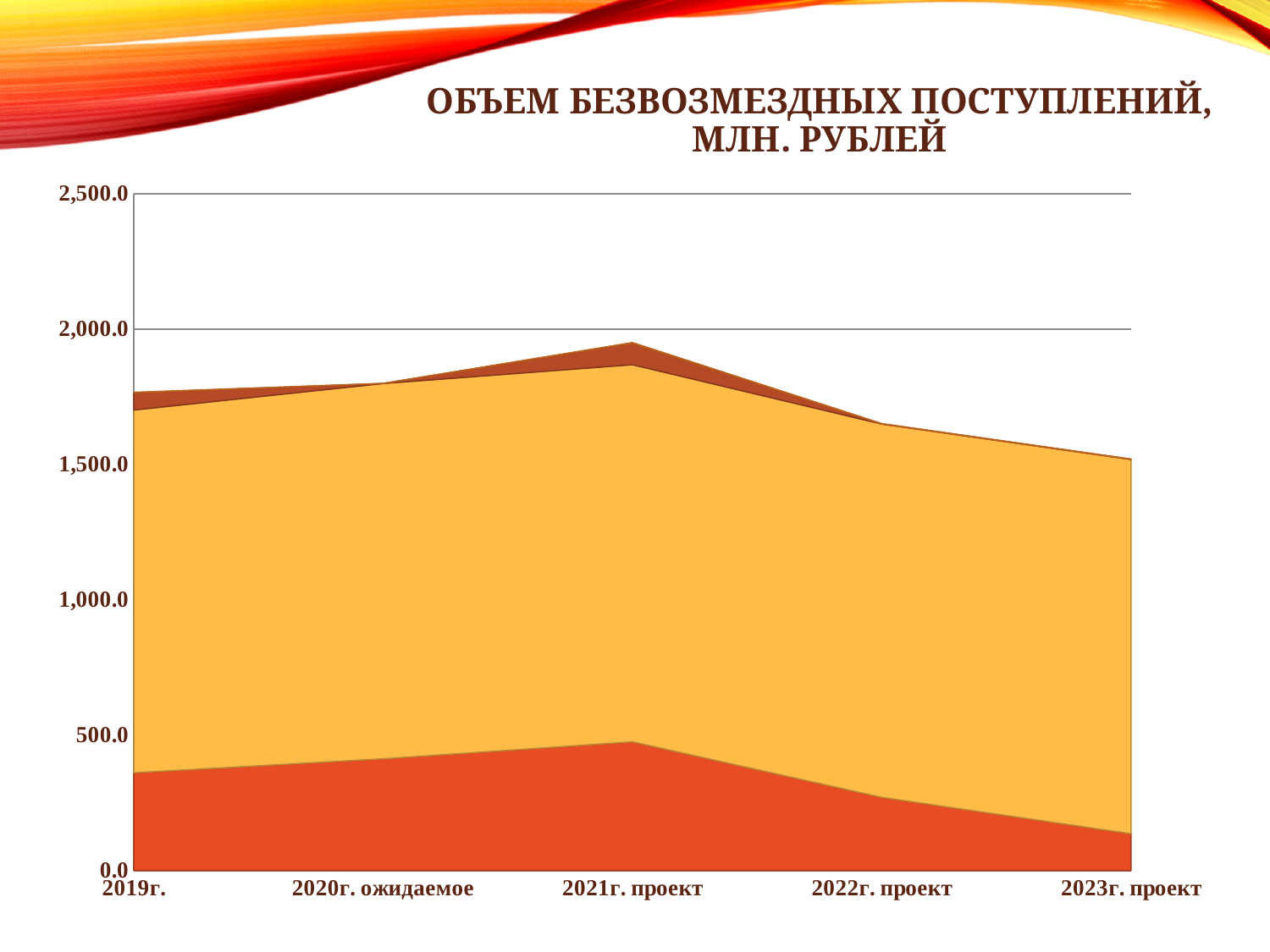
Is the stacked total for 2019г. greater or less than 1,500.0? greater What kind of chart is shown on the slide? area chart How many categories are shown along the x axis? 5 Does the stacked total rise or fall from 2021г. проект to 2023г. проект? fall Is the value of the bottom (red-orange) series for 2021г. проект greater or less than 500.0? less In which category does the stacked total reach its highest point? 2021г. проект Is the stacked total for 2022г. проект greater or less than 1,500.0? greater Is the stacked total for 2021г. проект larger or smaller than the stacked total for 2023г. проект? larger What is the title of the chart? ОБЪЕМ БЕЗВОЗМЕЗДНЫХ ПОСТУПЛЕНИЙ, МЛН. РУБЛЕЙ In which category is the stacked total lowest? 2023г. проект